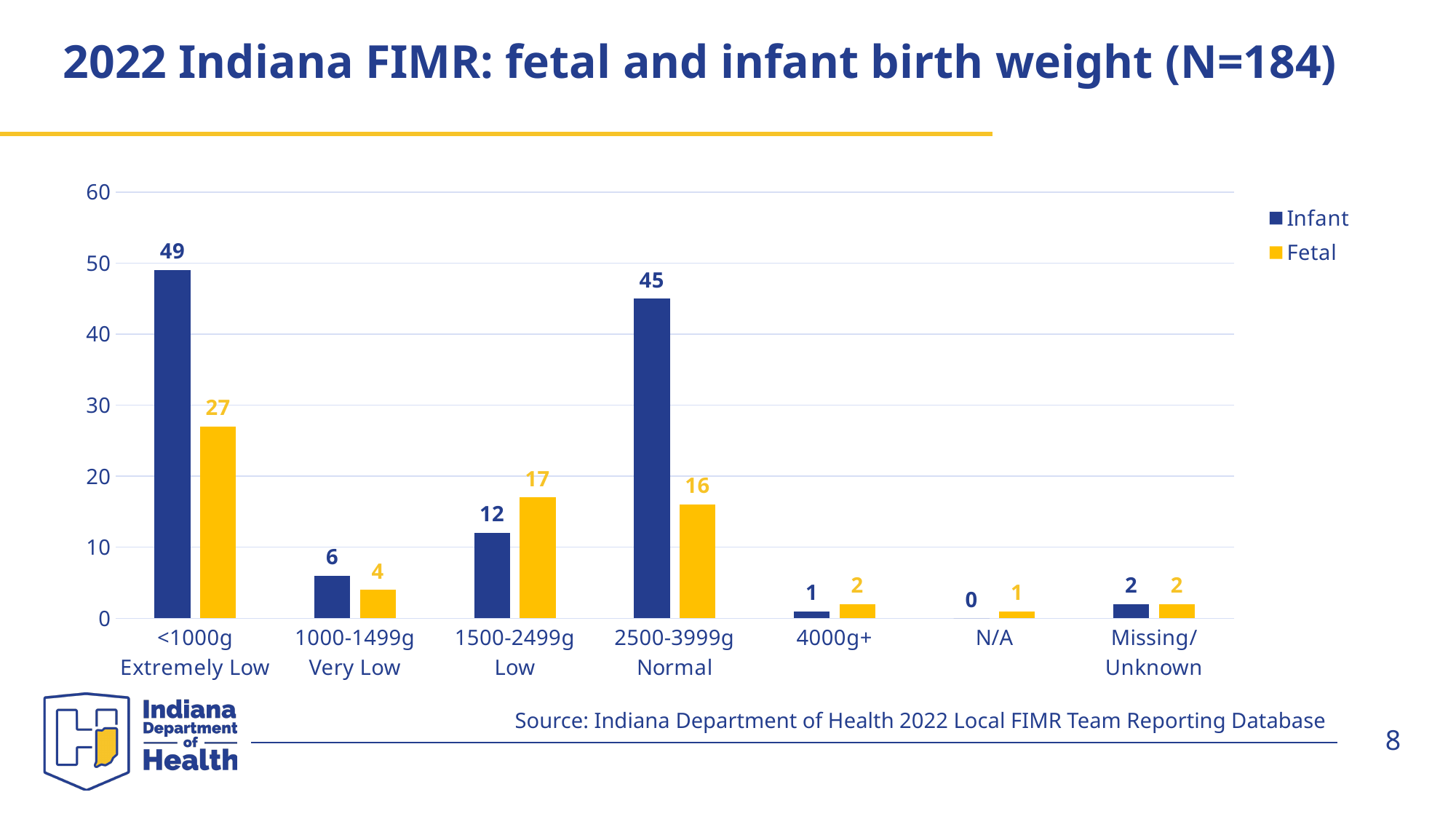
Is the Infant value for the 2500-3999g Normal category greater or less than 40? greater Which is larger for the 1500-2499g Low category, the Infant value or the Fetal value? Fetal What is the difference between the Infant and Fetal values for the 2500-3999g Normal category? 29 What kind of chart is shown on the slide? bar chart Which category has the lowest Infant value? N/A How many series does the legend list? 2 Which colour represents the Fetal series? yellow What is the Infant value for the N/A category? 0 Which category has the highest Fetal value? <1000g Extremely Low What is the Infant value for the <1000g Extremely Low category? 49 What is the Fetal value for the 1500-2499g Low category? 17 How many birth weight categories are shown on the x axis? 7